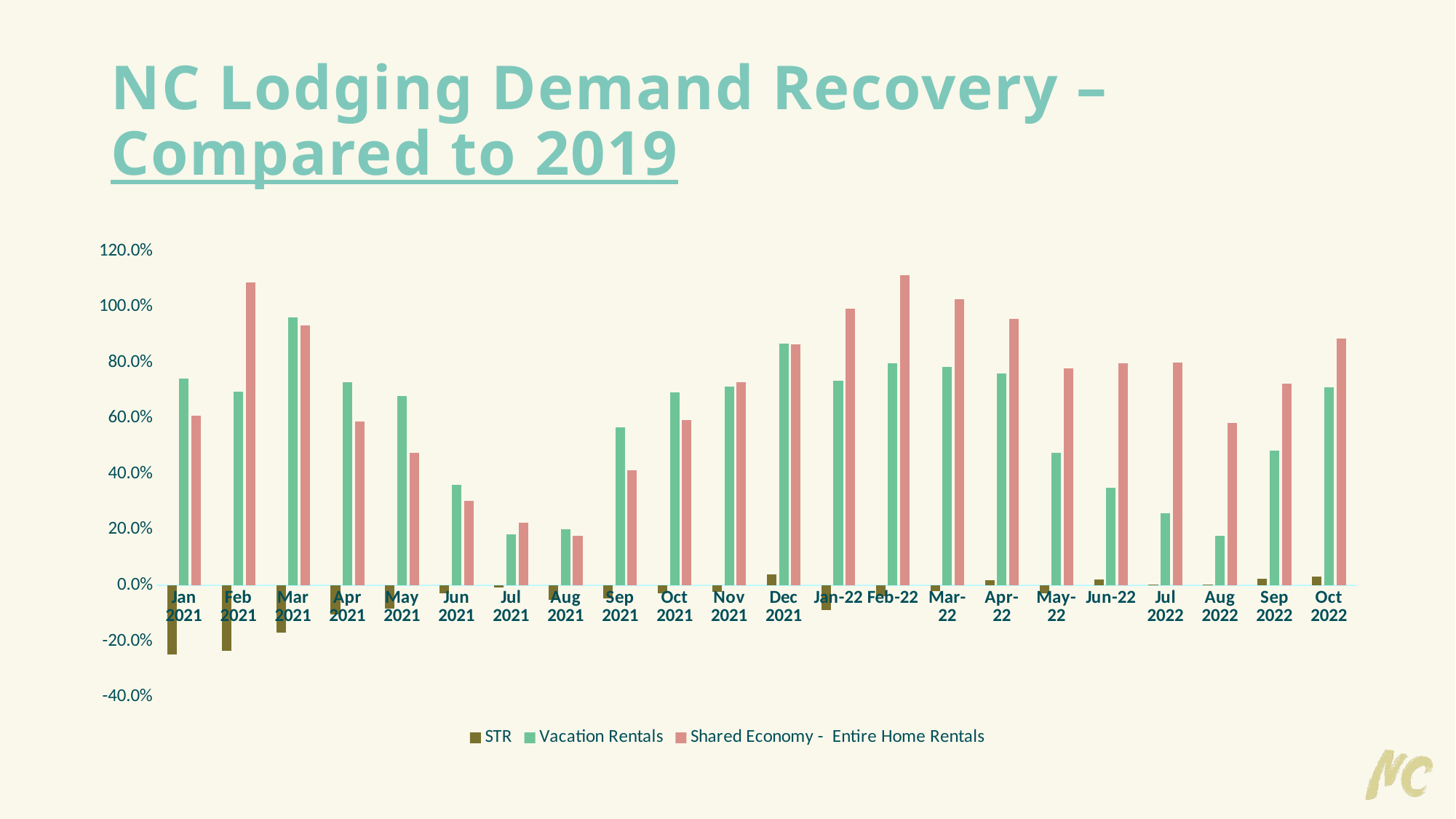
Do the Vacation Rentals values rise or fall from Mar 2021 to Jul 2021? fall Is the Shared Economy - Entire Home Rentals value for Feb 2021 greater or less than 100.0%? greater Is the Vacation Rentals value for Jun 2021 greater or less than 40.0%? less In which month does the Shared Economy - Entire Home Rentals series reach its highest value? Feb-22 In which month does the Vacation Rentals series reach its highest value? Mar 2021 What is the title of the chart on the slide? NC Lodging Demand Recovery – Compared to 2019 What kind of chart is shown on the slide? bar chart Is the Shared Economy - Entire Home Rentals value for Oct 2022 greater or less than 80.0%? greater How many months are shown along the x axis? 22 In Jan 2021, which is larger: Vacation Rentals or Shared Economy - Entire Home Rentals? Vacation Rentals How many series does the legend list? 3 In which month is the Shared Economy - Entire Home Rentals value lowest? Aug 2021